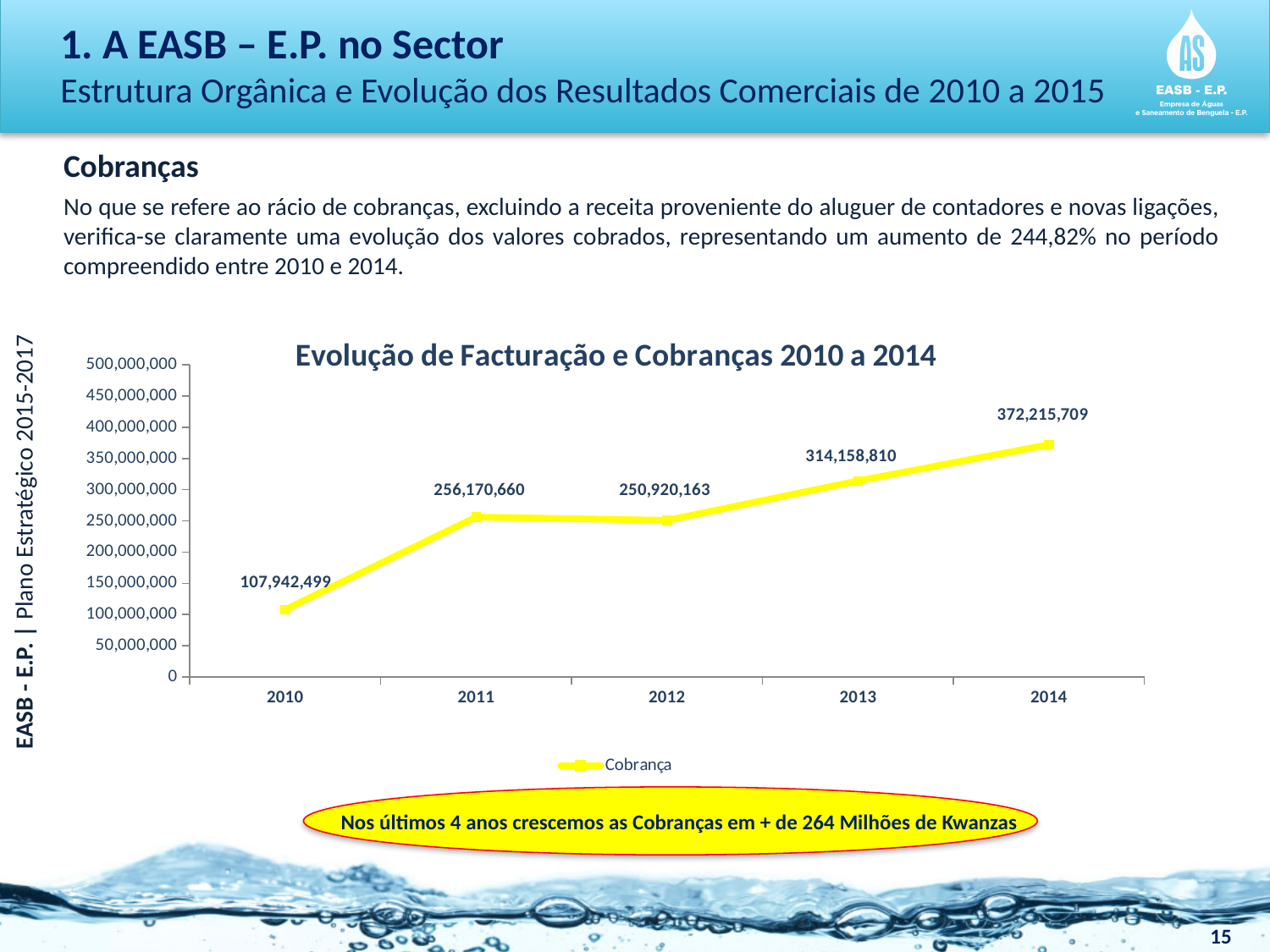
What is the value of Cobrança for 2014? 372,215,709 What is the difference between the Cobrança values for 2014 and 2010? 264,273,210 Is the Cobrança value for 2013 greater or less than 300,000,000? greater What is the value of Cobrança for 2012? 250,920,163 What type of chart is shown on the slide? Line chart How many years are plotted on the x axis? 5 What is the value of Cobrança for 2010? 107,942,499 What is the title of the chart? Evolução de Facturação e Cobranças 2010 a 2014 Which year has the lowest Cobrança value? 2010 What is the difference between the Cobrança values for 2011 and 2012? 5,250,497 Which year has the highest Cobrança value? 2014 Which year has a larger Cobrança value, 2011 or 2012? 2011